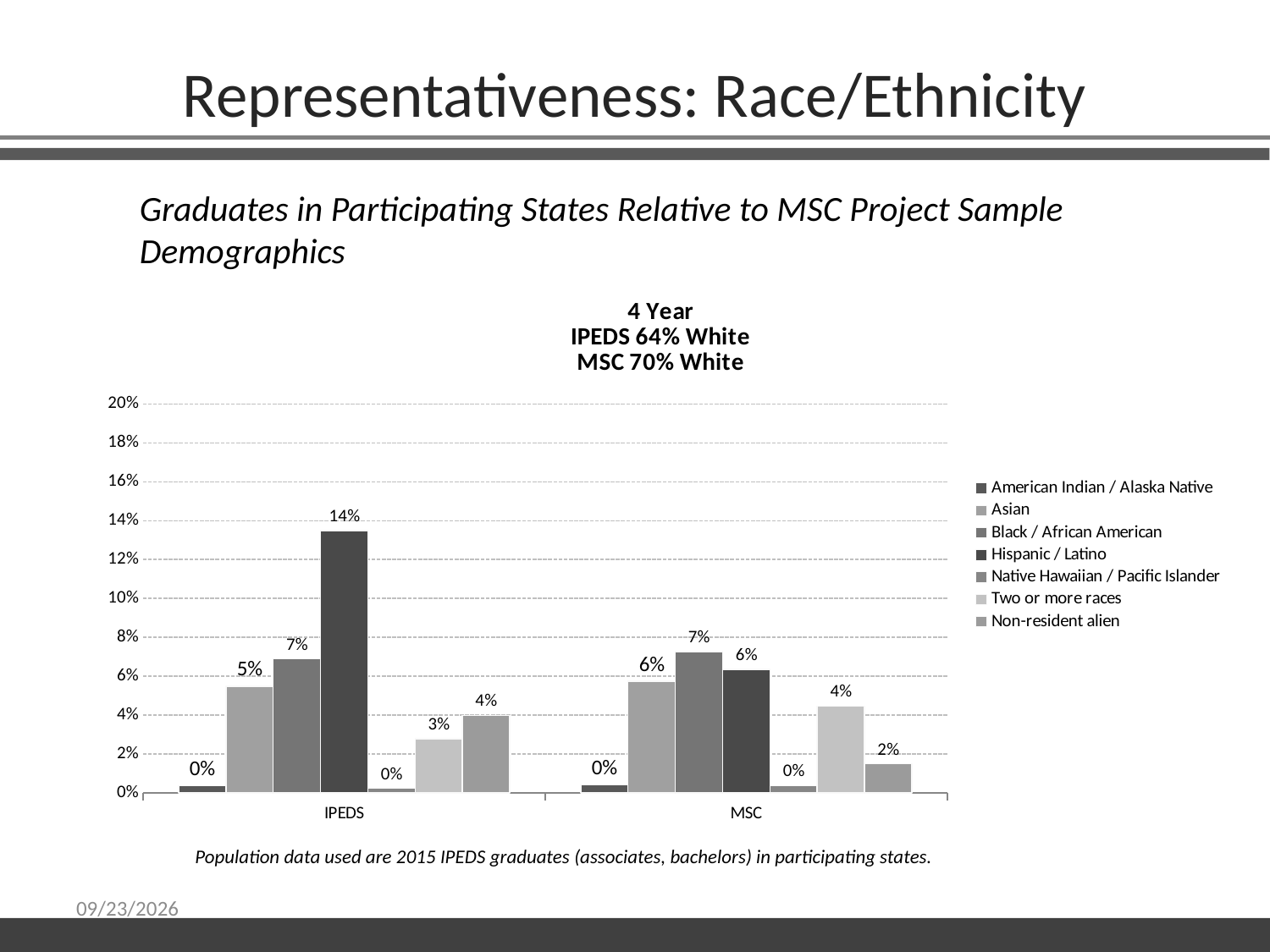
What is the value for Two or more races in the IPEDS group? 3% Which series has the highest value in the IPEDS group? Hispanic / Latino How many series does the legend list? 7 What is the value for Black / African American in the MSC group? 7% What is the value for Hispanic / Latino in the IPEDS group? 14% What is the title of the chart? 4 Year IPEDS 64% White MSC 70% White What is the difference between the Hispanic / Latino value for IPEDS and for MSC? 8 percentage points Is the Non-resident alien value larger for IPEDS or for MSC? IPEDS How many categories are shown on the x axis? 2 What kind of chart is shown on the slide? Bar chart Is the value for Hispanic / Latino in the IPEDS group greater or less than 10%? greater What is the value for Asian in the MSC group? 6%